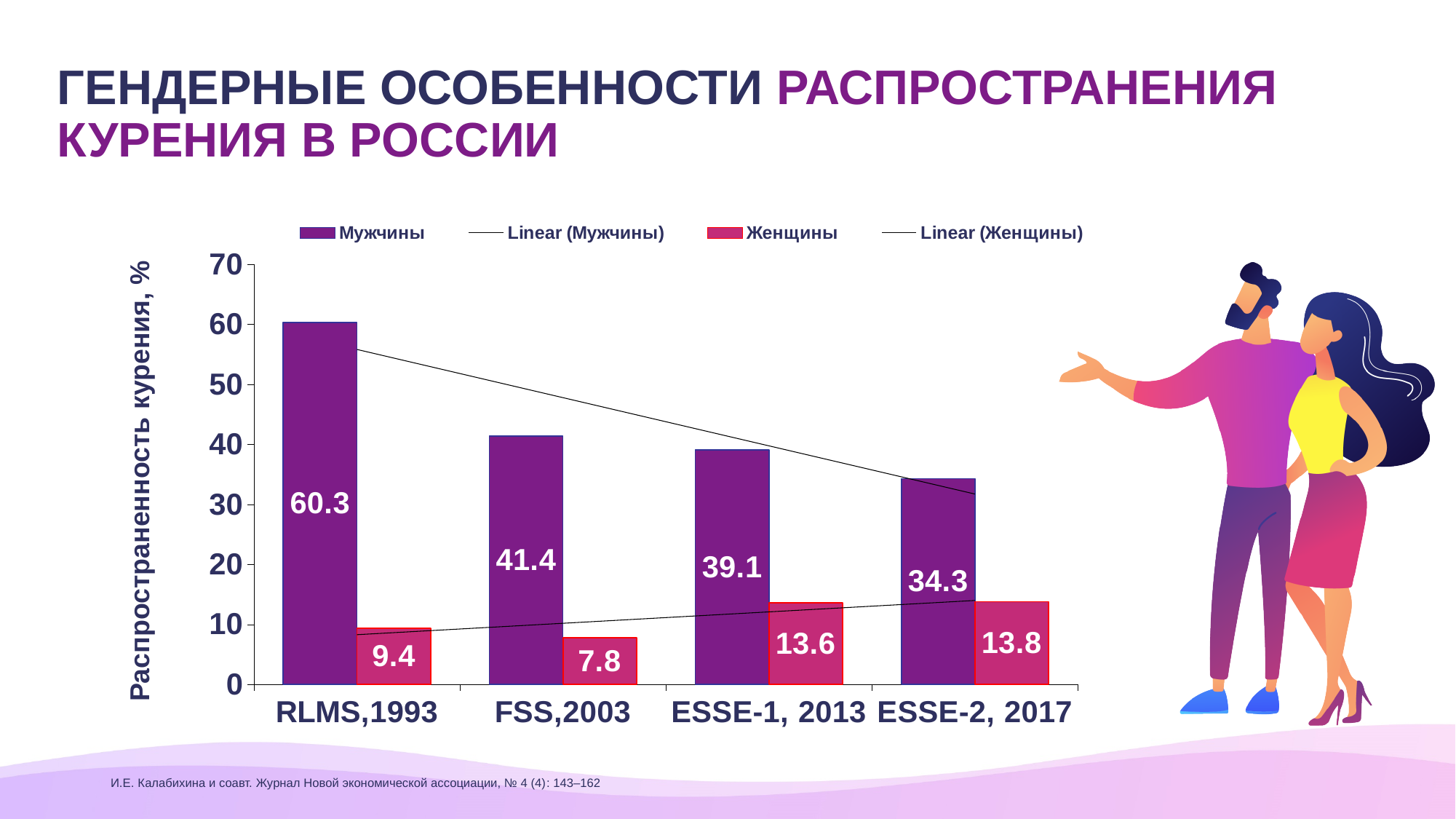
How many entries does the legend list? 4 Which category has the lowest value for Женщины? FSS,2003 Which is larger: the Мужчины value at FSS,2003 or at ESSE-2, 2017? FSS,2003 Which category has the highest value for Мужчины? RLMS,1993 What kind of chart is shown on the slide? bar chart What is the value for Женщины at FSS,2003? 7.8 What is the difference between the Мужчины and Женщины values at ESSE-1, 2013? 25.5 Do the Мужчины values rise or fall from RLMS,1993 to ESSE-2, 2017? fall What is the value for Женщины at ESSE-2, 2017? 13.8 What is the value for Мужчины at RLMS,1993? 60.3 How many categories are shown on the x axis? 4 Is the value for Мужчины at ESSE-1, 2013 greater or less than 40? less